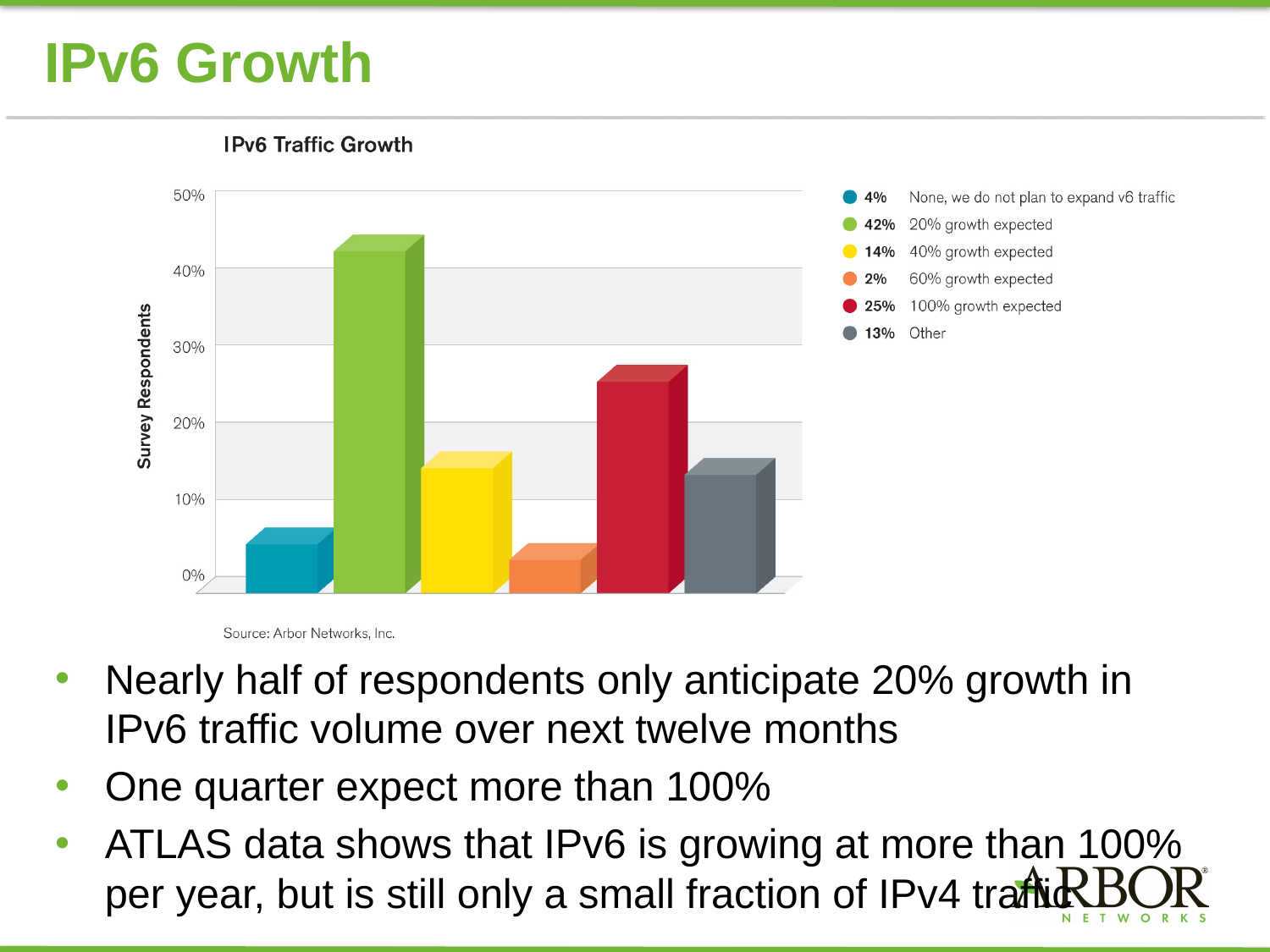
What percentage of survey respondents expect 100% growth? 25% Which has more respondents: 40% growth expected or Other? 40% growth expected What percentage of survey respondents expect 20% growth in IPv6 traffic? 42% How many response categories are shown in the chart? 6 What percentage of respondents answered 'Other'? 13% Which response category has the lowest share of survey respondents? 60% growth expected What type of chart is used to show IPv6 Traffic Growth? Bar chart What is the difference in percentage points between respondents expecting 20% growth and those expecting 100% growth? 17 What is the label on the vertical axis of the chart? Survey Respondents What is the title of the chart? IPv6 Traffic Growth What percentage of respondents do not plan to expand v6 traffic? 4% Which response category has the highest share of survey respondents? 20% growth expected